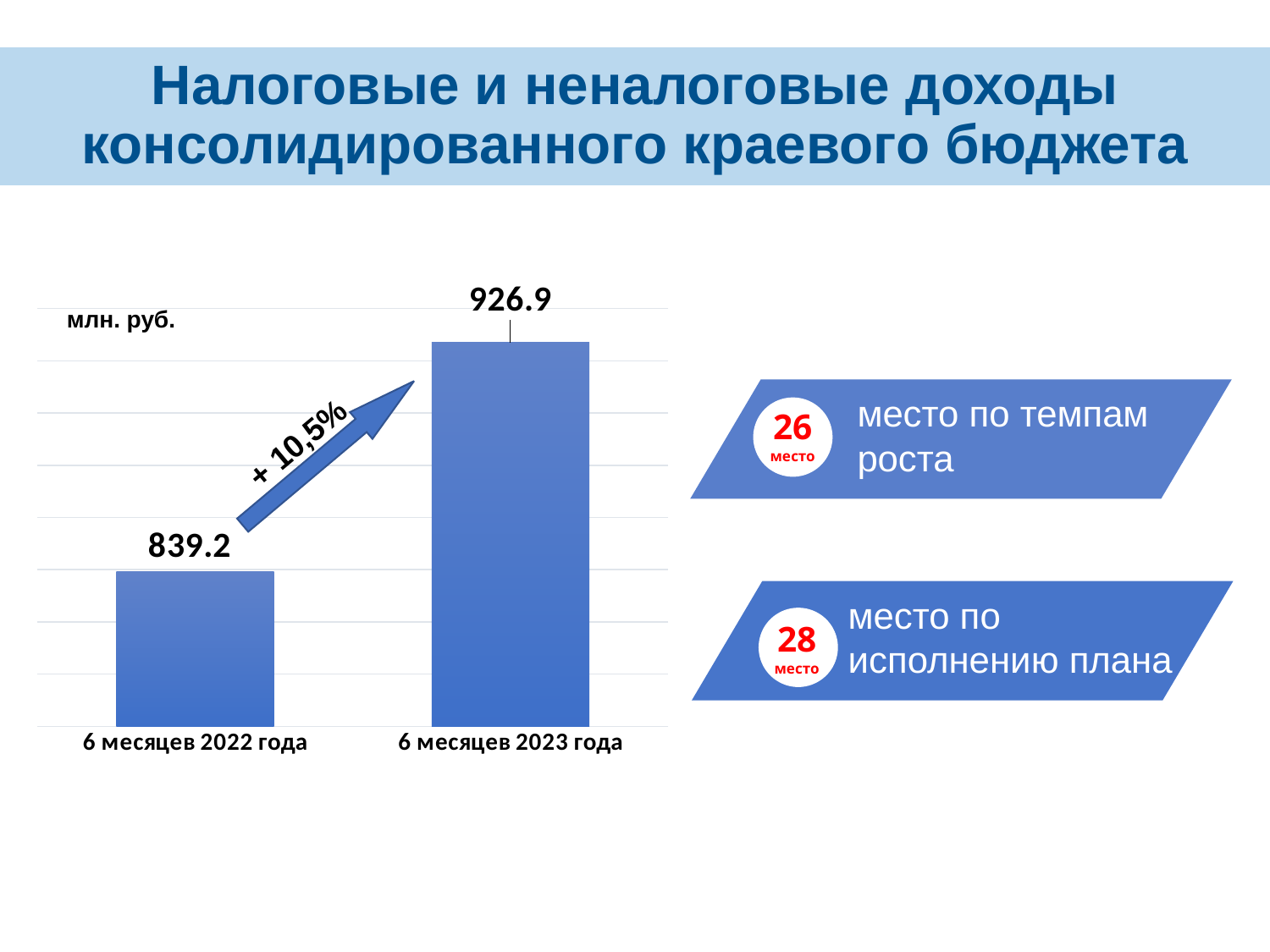
Which is larger, the value for 6 месяцев 2022 года or for 6 месяцев 2023 года? 6 месяцев 2023 года What kind of chart is shown on the slide? bar chart How many bars are shown in the chart? 2 What is the value for 6 месяцев 2023 года? 926.9 Which category has the highest value? 6 месяцев 2023 года What is the difference between the values for 6 месяцев 2023 года and 6 месяцев 2022 года? 87.7 What percentage change is shown by the arrow between the two bars? + 10,5% Which category has the lowest value? 6 месяцев 2022 года What is the value for 6 месяцев 2022 года? 839.2 What unit is indicated on the chart? млн. руб. Do the values rise or fall from 6 месяцев 2022 года to 6 месяцев 2023 года? rise